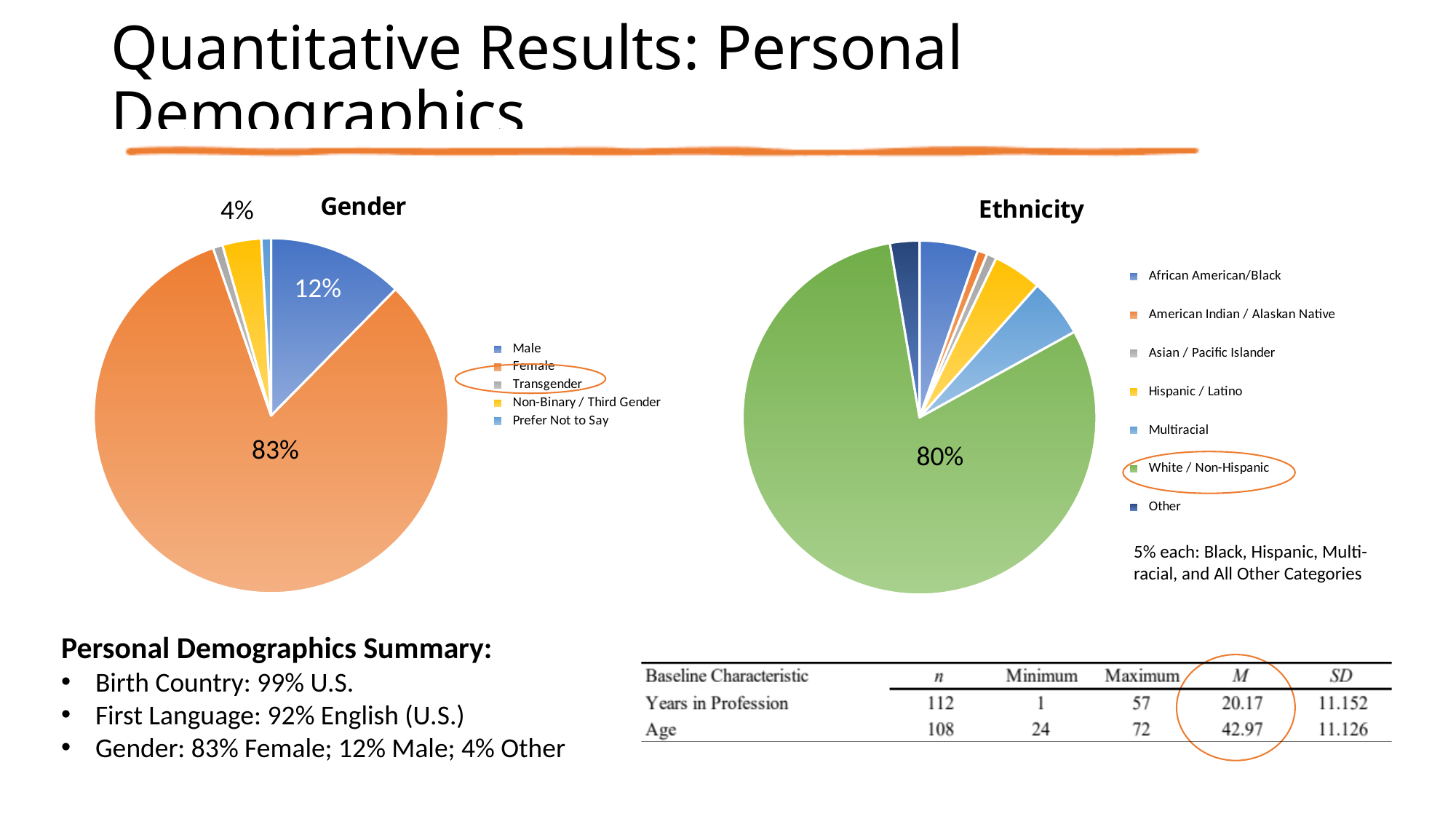
How many categories does the legend of the Ethnicity chart list? 7 Which is larger: the Female share in the Gender chart or the White / Non-Hispanic share in the Ethnicity chart? Female (83%) In the Gender chart, which category has the largest slice? Female In the Ethnicity chart, which category has the largest slice? White / Non-Hispanic In the Ethnicity chart, what percentage of respondents are White / Non-Hispanic? 80% What kind of chart is the Gender chart? Pie chart In the Gender chart, what percentage of respondents are Male? 12% What kind of chart is the Ethnicity chart? Pie chart In the Gender chart, what percentage of respondents are Female? 83% In the Gender chart, which slice is larger, Male or Non-Binary / Third Gender? Male In the Gender chart, what is the difference between the Female and Male percentages? 71% How many categories does the legend of the Gender chart list? 5